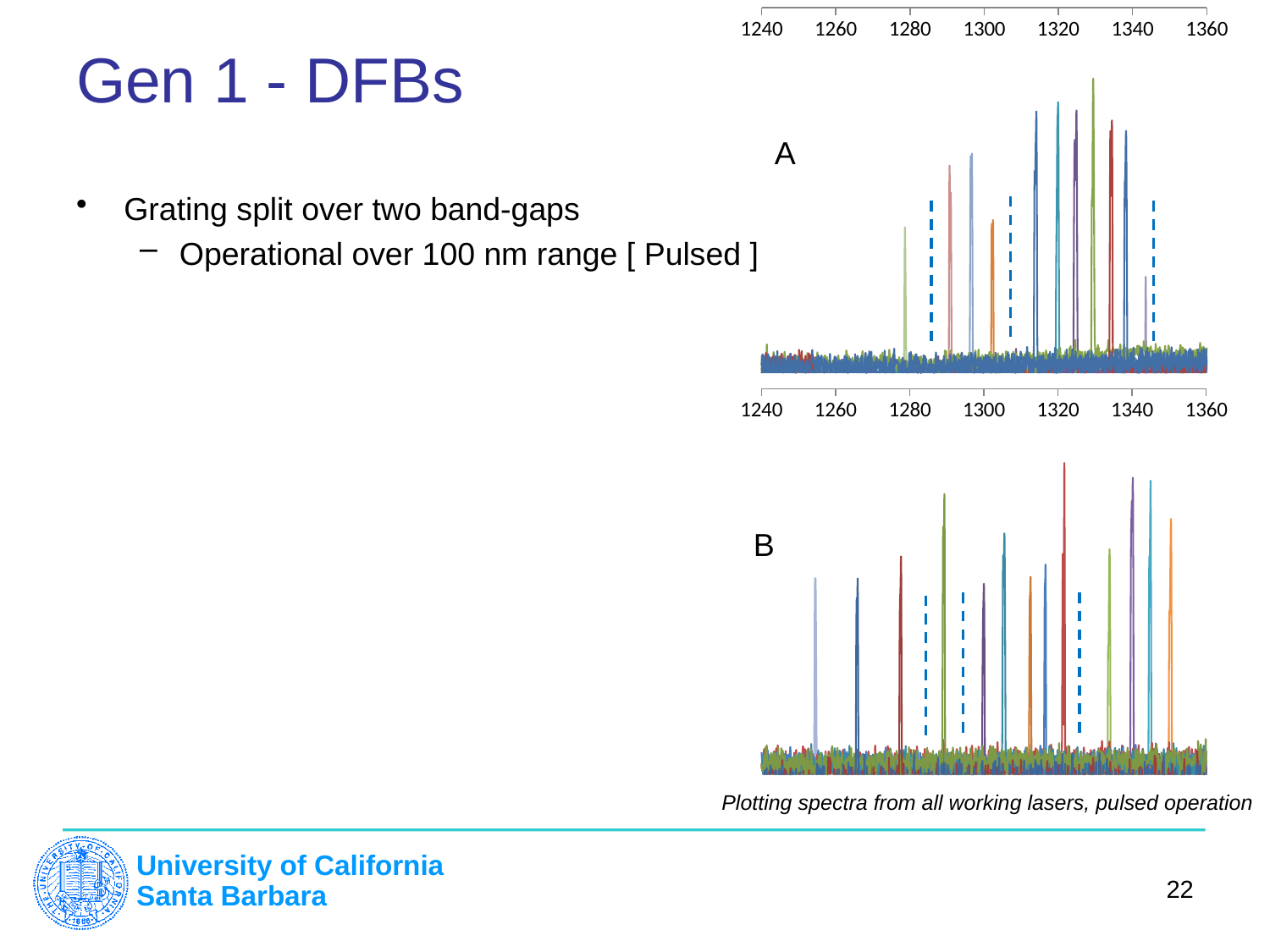
What is the spacing between consecutive x-axis ticks on chart B? 20 In chart B, is the wavelength of the rightmost peak greater or less than 1340? greater In chart B, is the wavelength of the leftmost peak greater or less than 1260? less How many spectrum charts are shown on the slide? 2 In chart A, is the leftmost peak taller or shorter than the rightmost peak? taller In chart A, is the wavelength of the tallest peak greater or less than 1320? greater What are the lowest and highest wavelength ticks on the x axis of chart A? 1240 and 1360 In chart B, is the leftmost peak taller or shorter than the rightmost peak? shorter What kind of chart is used for the spectra labelled A and B? line chart